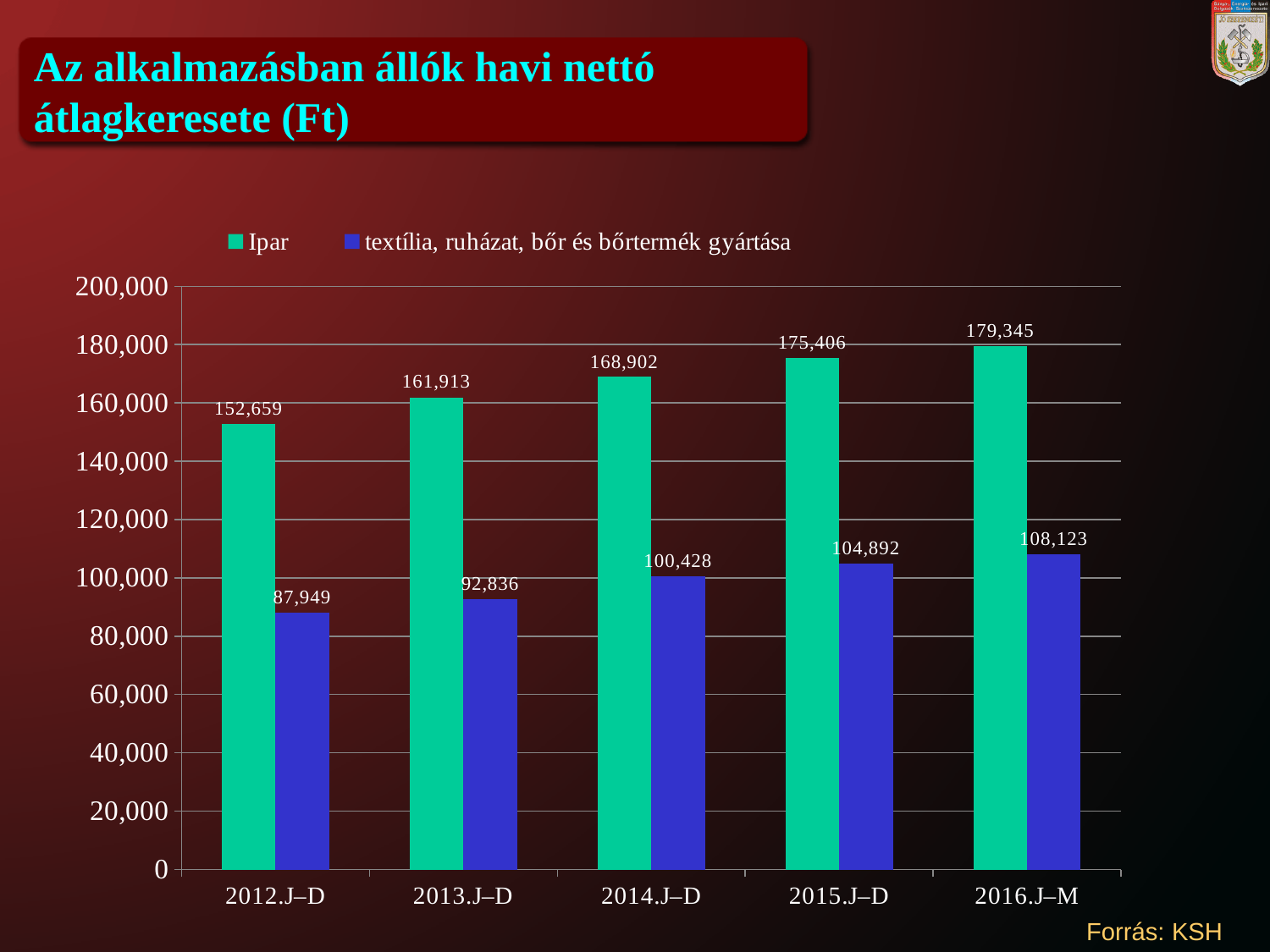
In which period is the value for textília, ruházat, bőr és bőrtermék gyártása the highest? 2016.J–M What is the difference between the Ipar value and the textília, ruházat, bőr és bőrtermék gyártása value in 2016.J–M? 71,222 What kind of chart is shown on the slide? Bar chart By how much did the Ipar value increase from 2012.J–D to 2016.J–M? 26,686 Which is larger: the Ipar value in 2013.J–D or the textília, ruházat, bőr és bőrtermék gyártása value in 2016.J–M? Ipar in 2013.J–D How many periods are shown on the x axis? 5 In which period is the value for Ipar the lowest? 2012.J–D What is the value for Ipar in 2012.J–D? 152,659 What is the value for Ipar in 2016.J–M? 179,345 Do the values for textília, ruházat, bőr és bőrtermék gyártása rise or fall from 2012.J–D to 2016.J–M? Rise How many series does the legend list? 2 What is the value for textília, ruházat, bőr és bőrtermék gyártása in 2014.J–D? 100,428